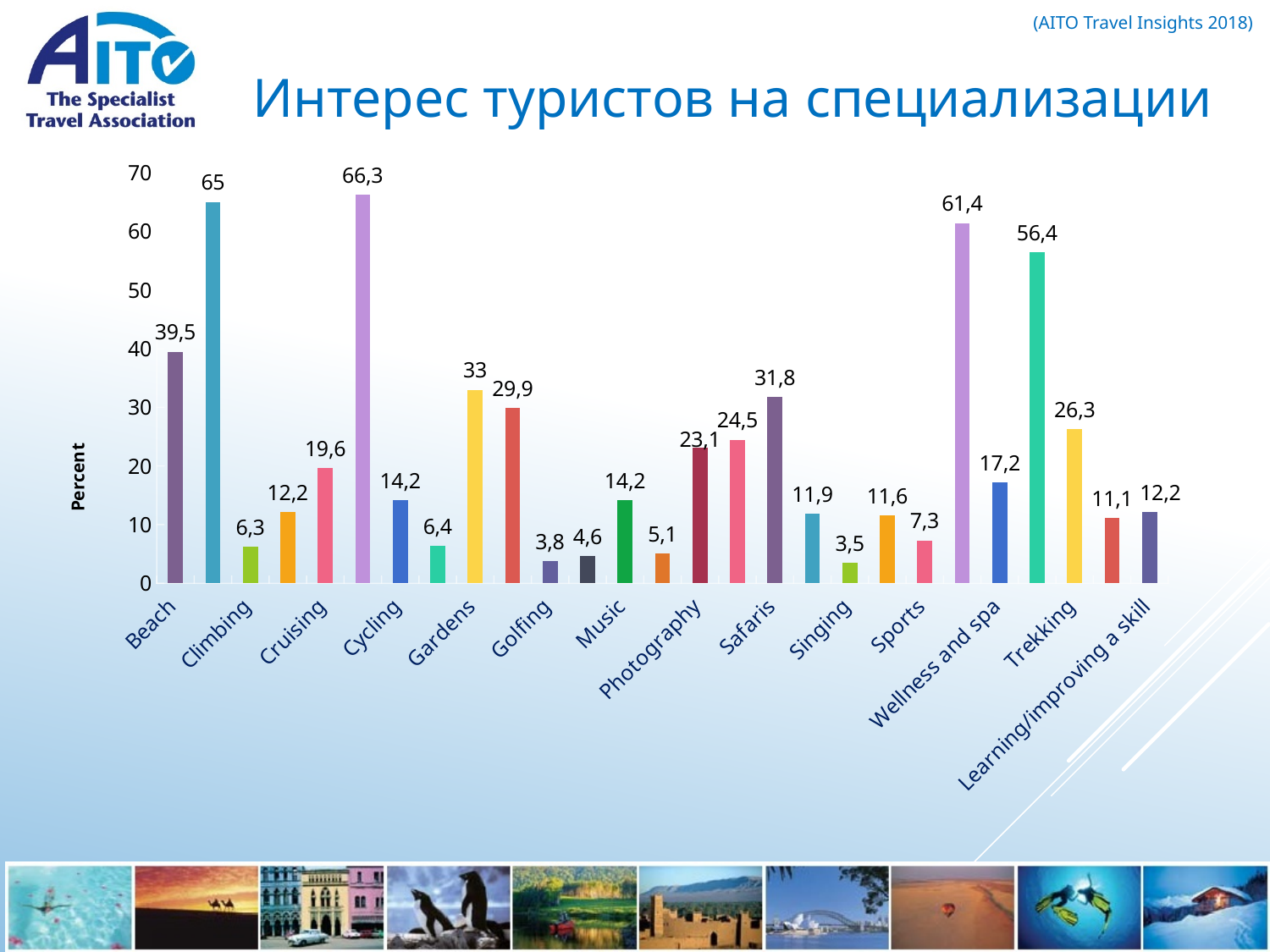
What is the lowest value shown on the chart? 3,5 What is the maximum value shown on the vertical axis? 70 What is the label of the vertical axis? Percent How many bars are plotted on the chart? 27 What is the value of the first bar, labelled Beach? 39,5 What is the value of the last bar, labelled Learning/improving a skill? 12,2 What is the difference between the highest value (66,3) and the lowest value (3,5) on the chart? 62,8 Is the value of the first bar (Beach) greater or less than 40? less What type of chart is shown on the slide? bar chart What is the highest value shown on the chart? 66,3 How many bars on the chart have a value above 60? 3